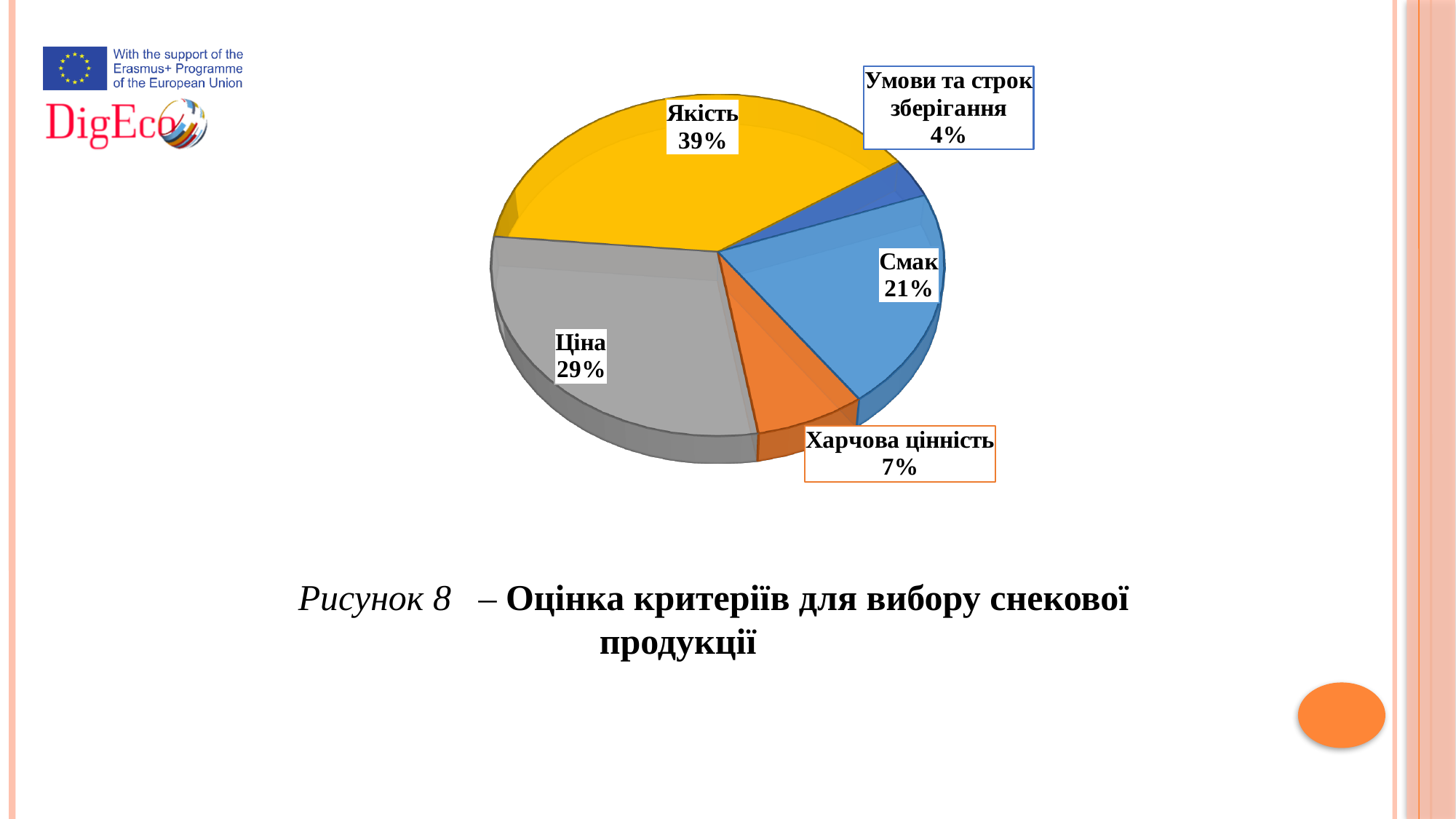
How many slices does the pie chart have? 5 What share of the pie does Смак have? 21% What share of the pie does Якість have? 39% Which category has the largest slice of the pie? Якість What is the difference in percentage points between Якість and Ціна? 10 Which is larger, the share for Смак or the share for Харчова цінність? Смак What share of the pie does Умови та строк зберігання have? 4% What share of the pie does Ціна have? 29% What colour is the slice for Ціна? grey What kind of chart is shown on the slide? pie chart What share of the pie does Харчова цінність have? 7% Which category has the smallest slice of the pie? Умови та строк зберігання